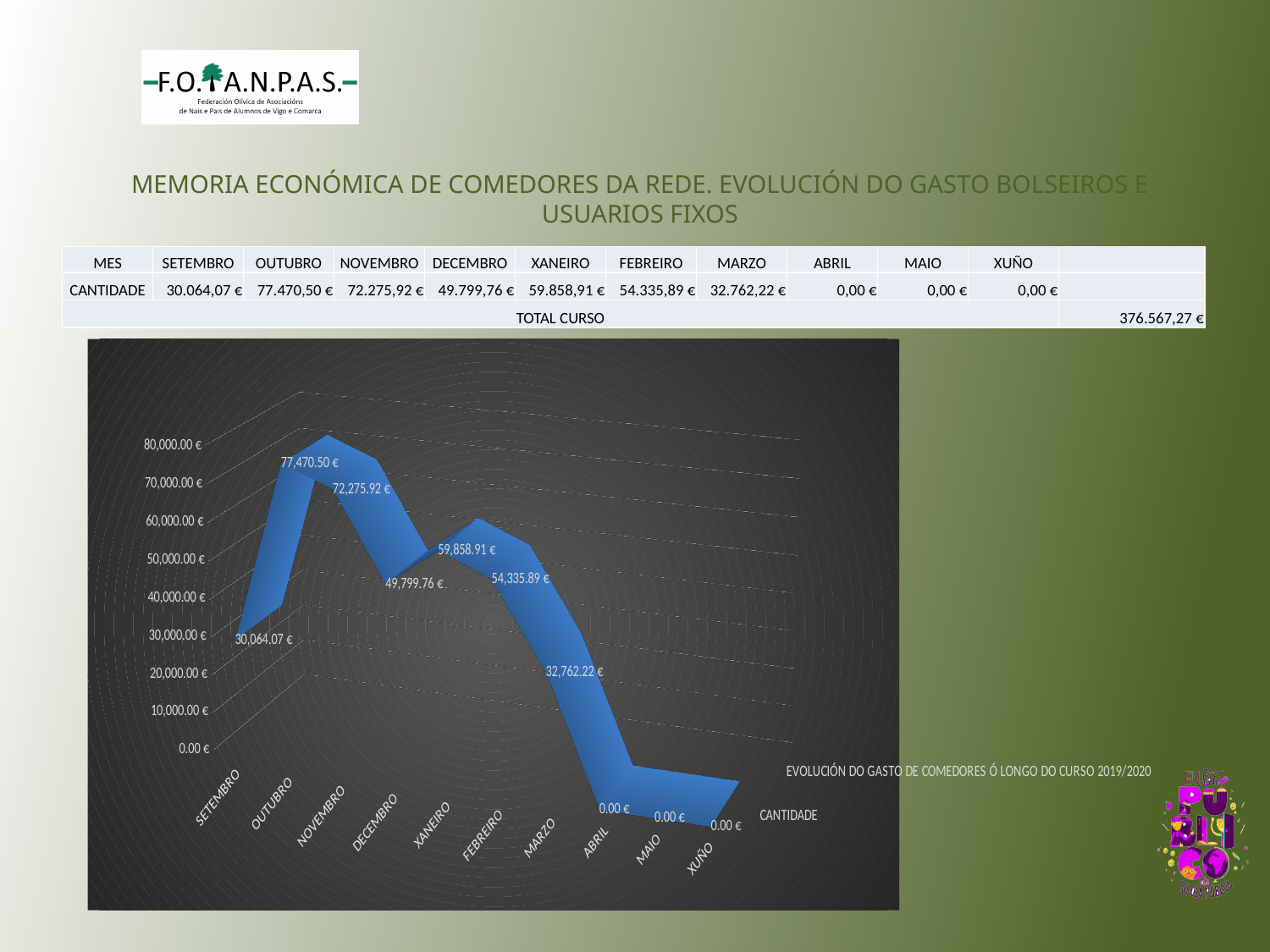
What is the value for OUTUBRO in the chart? 77,470.50 € Which month has the highest value in the chart? OUTUBRO What is the difference between the values for OUTUBRO and NOVEMBRO in the chart? 5,194.58 € How many months are plotted along the x axis of the chart? 10 What type of chart is shown on the slide? 3D line chart Which is larger in the chart, the value for XANEIRO or the value for FEBREIRO? XANEIRO What is the value for MARZO in the chart? 32,762.22 € What is the value for DECEMBRO in the chart? 49,799.76 € Is the value for SETEMBRO greater or less than 40,000.00 €? less Do the values rise or fall from XANEIRO to XUÑO in the chart? fall